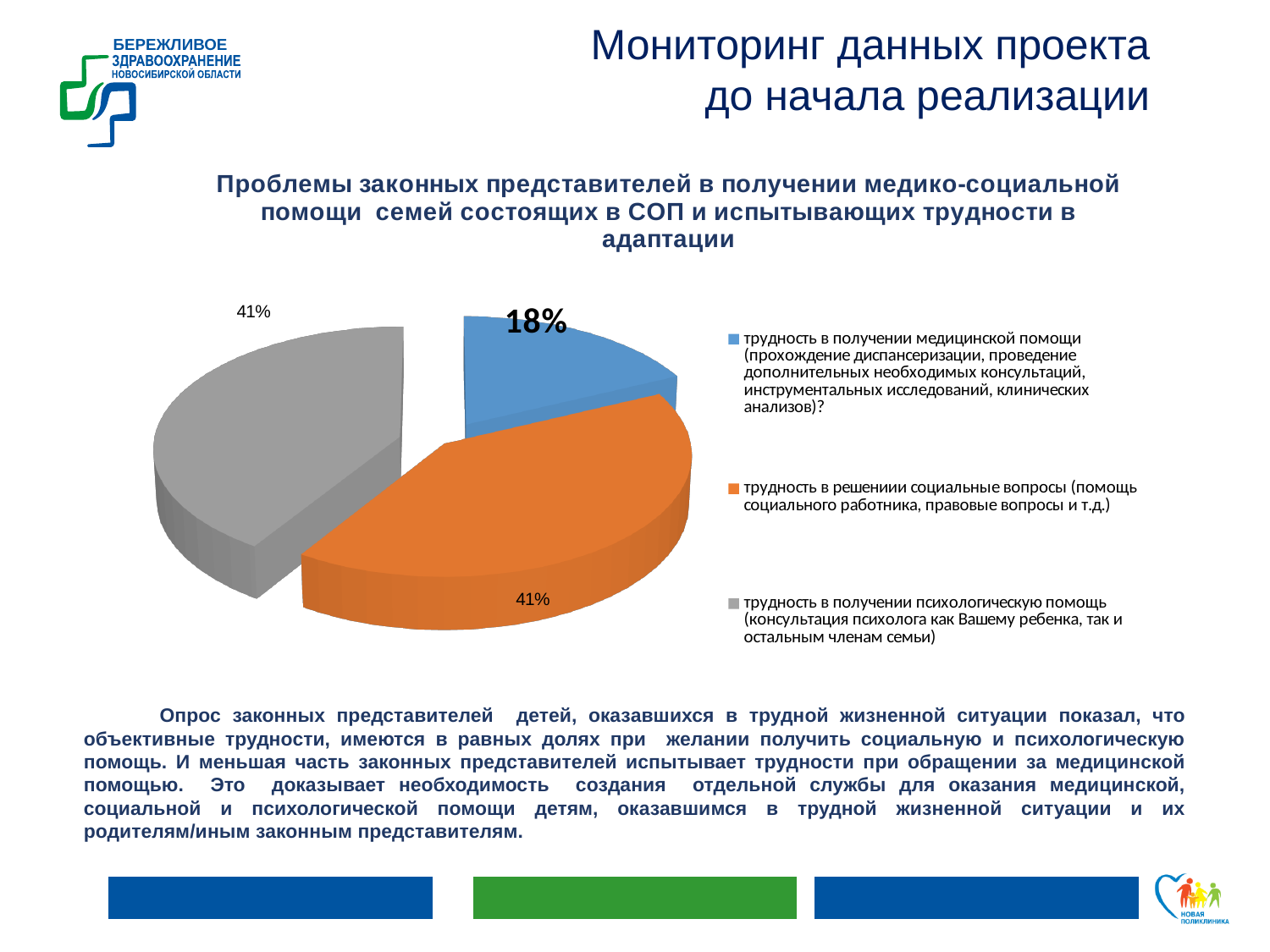
What percentage of the pie corresponds to difficulty in obtaining medical help (трудность в получении медицинской помощи)? 18% What colour is the slice representing difficulty in resolving social issues? orange Which category has the smallest share of the pie? трудность в получении медицинской помощи What percentage of the pie corresponds to difficulty in obtaining psychological help (трудность в получении психологическую помощь)? 41% What is the difference in percentage points between the share for social issues and the share for medical help? 23% What colour is the slice representing difficulty in obtaining psychological help? gray What type of chart is shown on the slide? pie chart Which is larger: the share for difficulty in obtaining medical help or the share for difficulty in resolving social issues? трудность в решениии социальные вопросы How many entries does the legend list? 3 How many slices does the pie chart have? 3 Is the share for difficulty in obtaining medical help greater or less than 20%? less What percentage of the pie corresponds to difficulty in resolving social issues (трудность в решениии социальные вопросы)? 41%